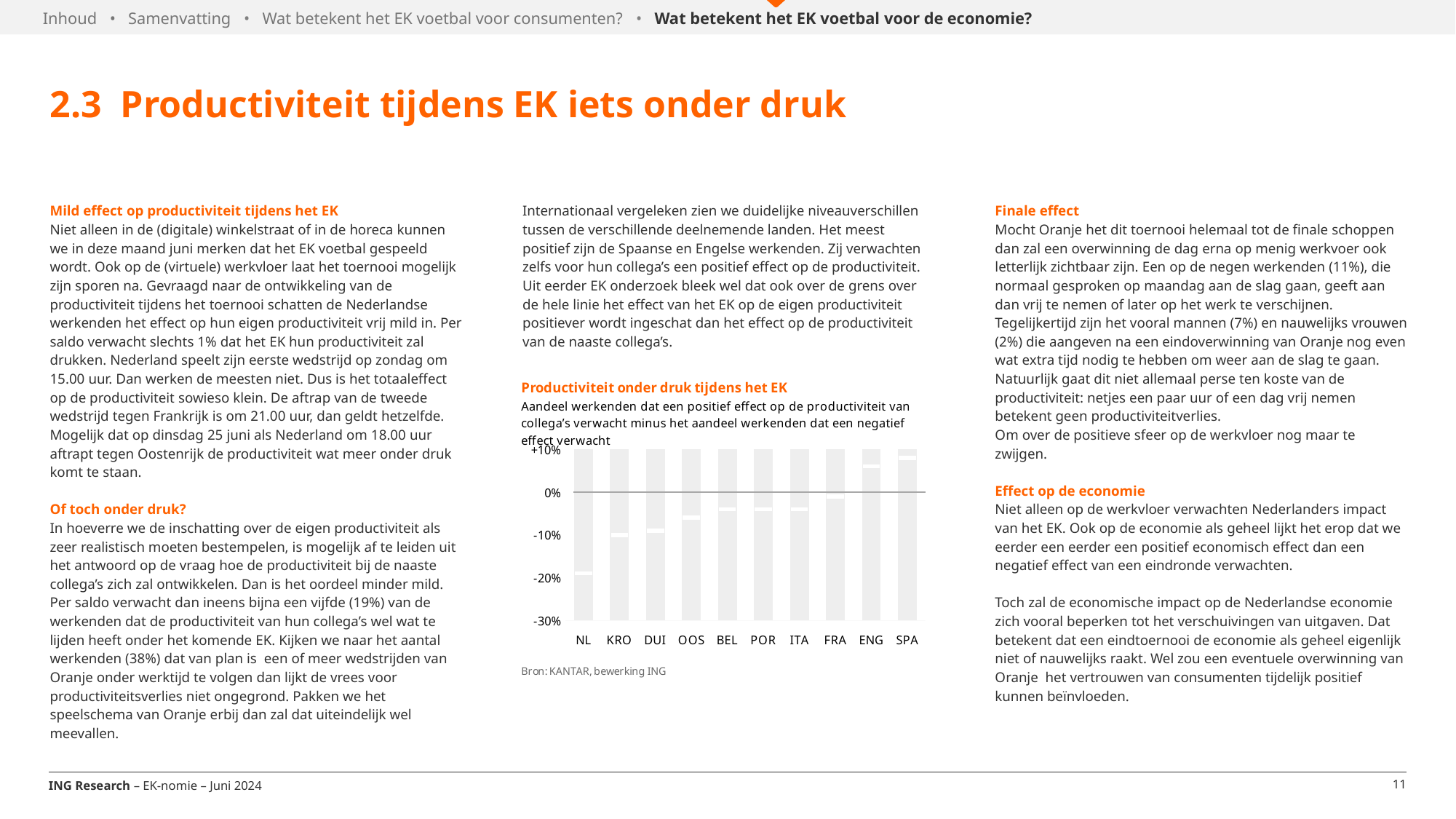
Is the value for NL greater or less than -10%? less Is the value for SPA greater or less than 0%? greater Which has the larger value, DUI or ENG? ENG Is the value for OOS greater or less than -10%? greater What kind of chart is shown under the title 'Productiviteit onder druk tijdens het EK'? line chart (markers only) Do the values generally rise or fall moving from NL on the left to SPA on the right? rise Which has the larger value, NL or KRO? KRO Which country has the lowest value in the chart? NL What source is cited below the chart? Bron: KANTAR, bewerking ING How many countries are shown on the x axis of the chart? 10